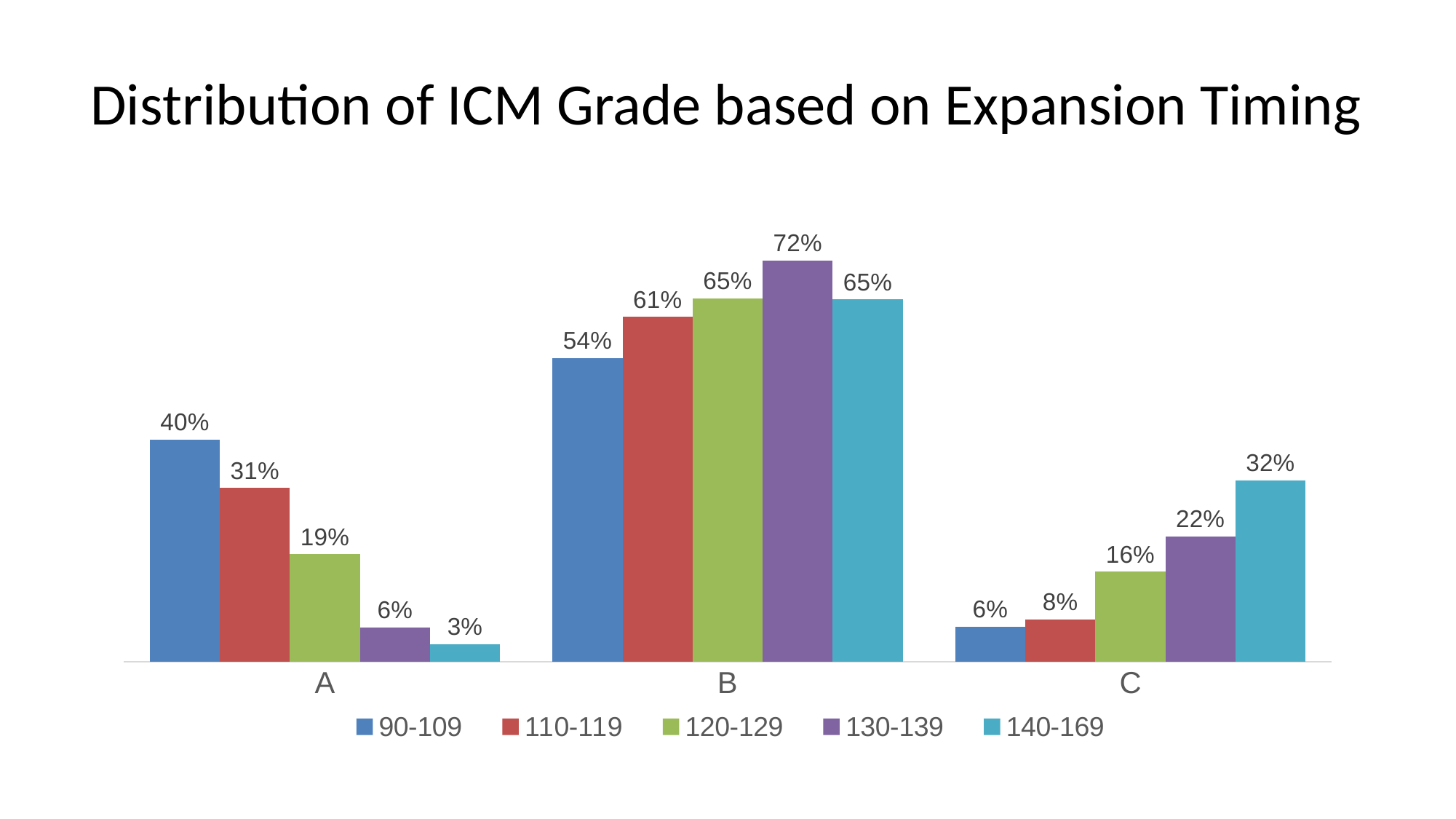
What is the difference between the 90-109 and 140-169 values at grade A? 37% What is the title of the chart? Distribution of ICM Grade based on Expansion Timing What is the value for the 120-129 series at grade C? 16% What is the value for the 130-139 series at grade B? 72% What is the value for the 140-169 series at grade C? 32% How many series does the legend list? 5 Which series has the highest value at grade B? 130-139 Which is larger at grade C: the 110-119 value or the 130-139 value? 130-139 What is the value for the 90-109 series at grade A? 40% How many grade categories are shown on the x axis? 3 What kind of chart is shown on the slide? Bar chart Which series has the lowest value at grade A? 140-169